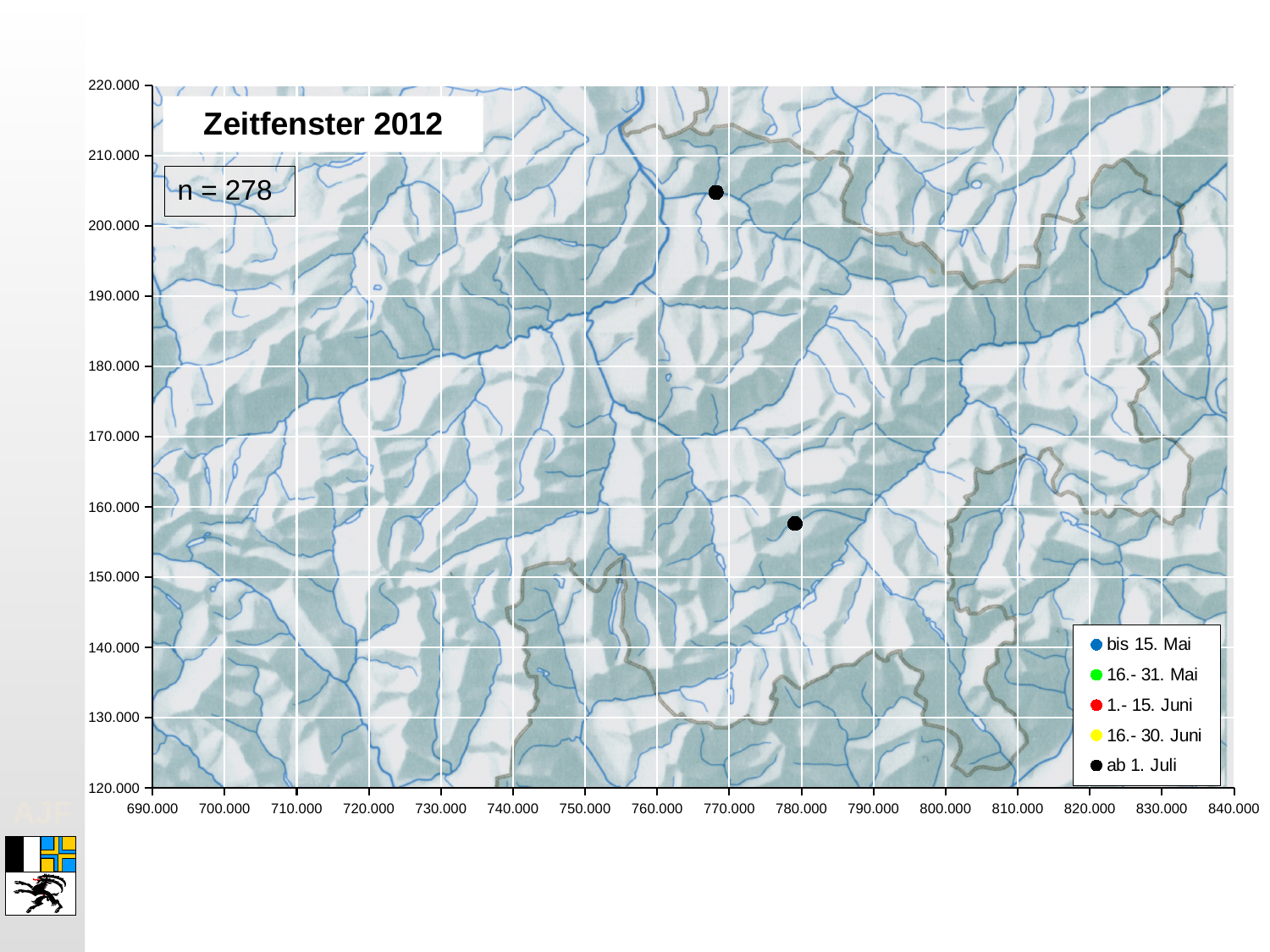
Is the y-value of the upper plotted point greater or less than 200.000? greater What value of n is shown on the chart? n = 278 Is the x-value of the upper plotted point greater or less than 760.000? greater What kind of chart is shown on the slide? scatter chart What is the highest value shown on the y axis? 220.000 What is the title of the chart? Zeitfenster 2012 Which of the two plotted points has the larger x-value, the upper one or the lower one? the lower one Is the x-value of the lower plotted point greater or less than 770.000? greater How many data points are plotted on the chart? 2 How many series does the legend list? 5 Which legend series do the plotted black points belong to? ab 1. Juli